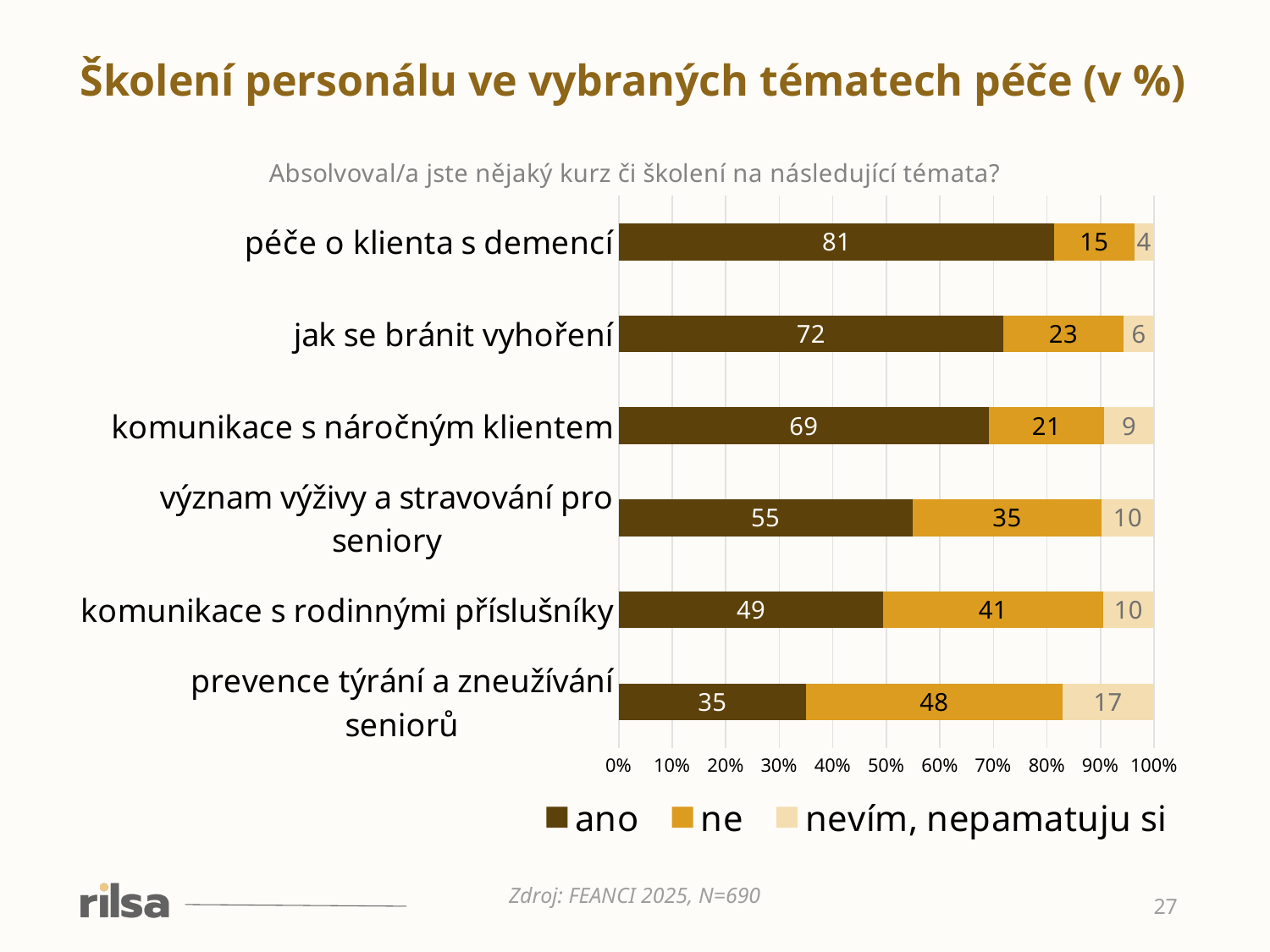
What is the value of "ano" for "péče o klienta s demencí"? 81 What is the title of the chart? Absolvoval/a jste nějaký kurz či školení na následující témata? Which is larger: the "ne" value for "význam výživy a stravování pro seniory" or for "jak se bránit vyhoření"? význam výživy a stravování pro seniory Which category has the lowest "ano" value? prevence týrání a zneužívání seniorů What is the difference between the "ano" values for "jak se bránit vyhoření" and "komunikace s náročným klientem"? 3 What is the value of "ne" for "komunikace s rodinnými příslušníky"? 41 What is the value of "nevím, nepamatuju si" for "prevence týrání a zneužívání seniorů"? 17 How many categories are shown in the chart? 6 How many series does the legend list? 3 What is the total of the stacked bar for "komunikace s náročným klientem"? 99 Which category has the highest "ano" value? péče o klienta s demencí What kind of chart is shown on the slide? stacked bar chart